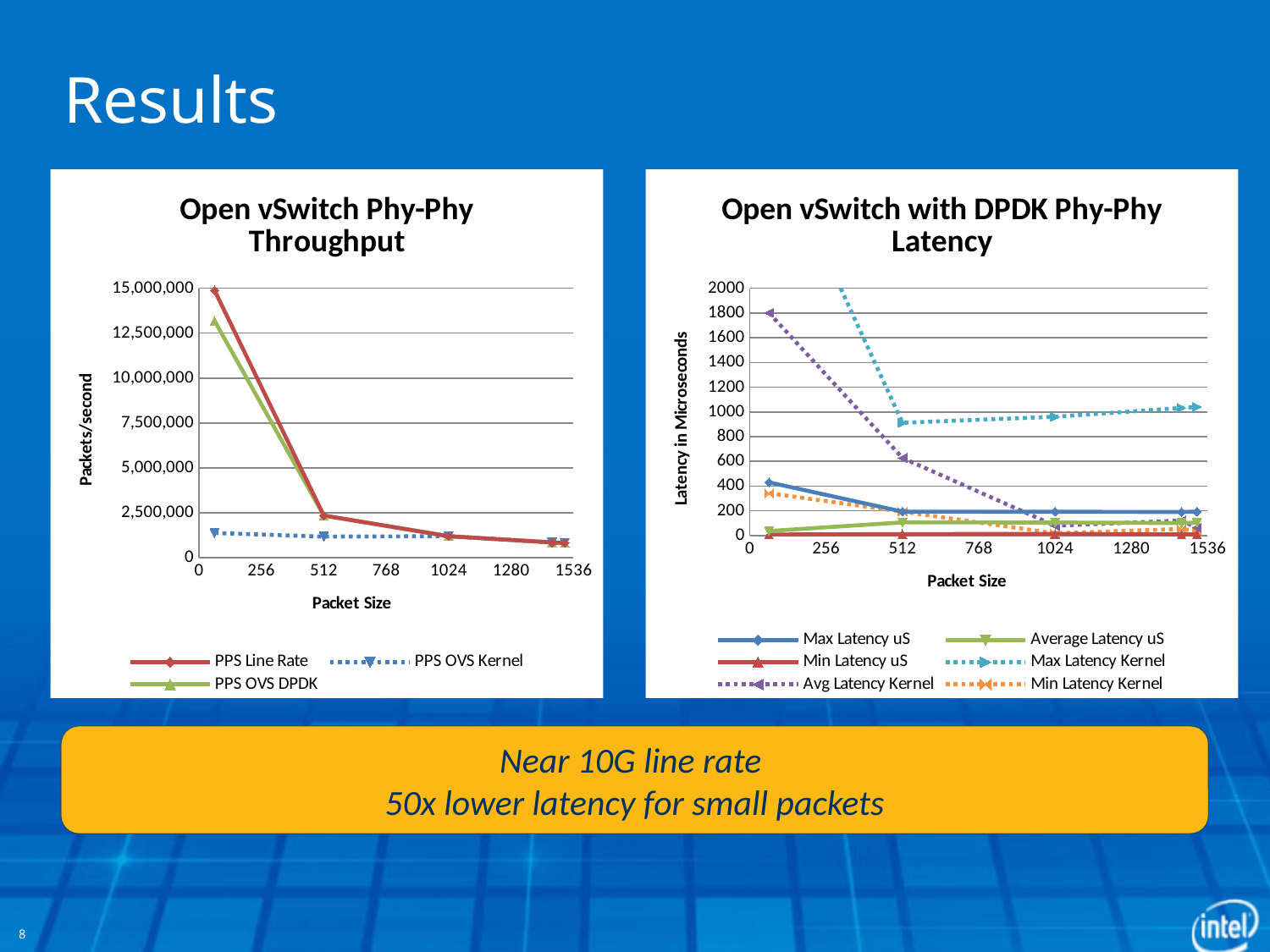
What is the y-axis title of the 'Open vSwitch with DPDK Phy-Phy Latency' chart? Latency in Microseconds In the 'Open vSwitch with DPDK Phy-Phy Latency' chart, at packet size 1024, which is larger: Max Latency Kernel or Max Latency uS? Max Latency Kernel In the 'Open vSwitch Phy-Phy Throughput' chart, does the PPS Line Rate rise or fall as packet size increases? fall In the 'Open vSwitch Phy-Phy Throughput' chart, at packet size 512, which is larger: PPS Line Rate or PPS OVS Kernel? PPS Line Rate How many series does the legend of the 'Open vSwitch with DPDK Phy-Phy Latency' chart list? 6 What kind of chart is the 'Open vSwitch Phy-Phy Throughput' chart? line chart In the 'Open vSwitch with DPDK Phy-Phy Latency' chart, is the Avg Latency Kernel value at the smallest packet size greater or less than 1600? greater In the 'Open vSwitch Phy-Phy Throughput' chart, is the PPS Line Rate value at the smallest packet size greater or less than 12,500,000? greater How many series does the legend of the 'Open vSwitch Phy-Phy Throughput' chart list? 3 In the 'Open vSwitch Phy-Phy Throughput' chart, is the PPS OVS Kernel value at the smallest packet size greater or less than 2,500,000? less In the 'Open vSwitch with DPDK Phy-Phy Latency' chart, does Avg Latency Kernel rise or fall as packet size increases? fall